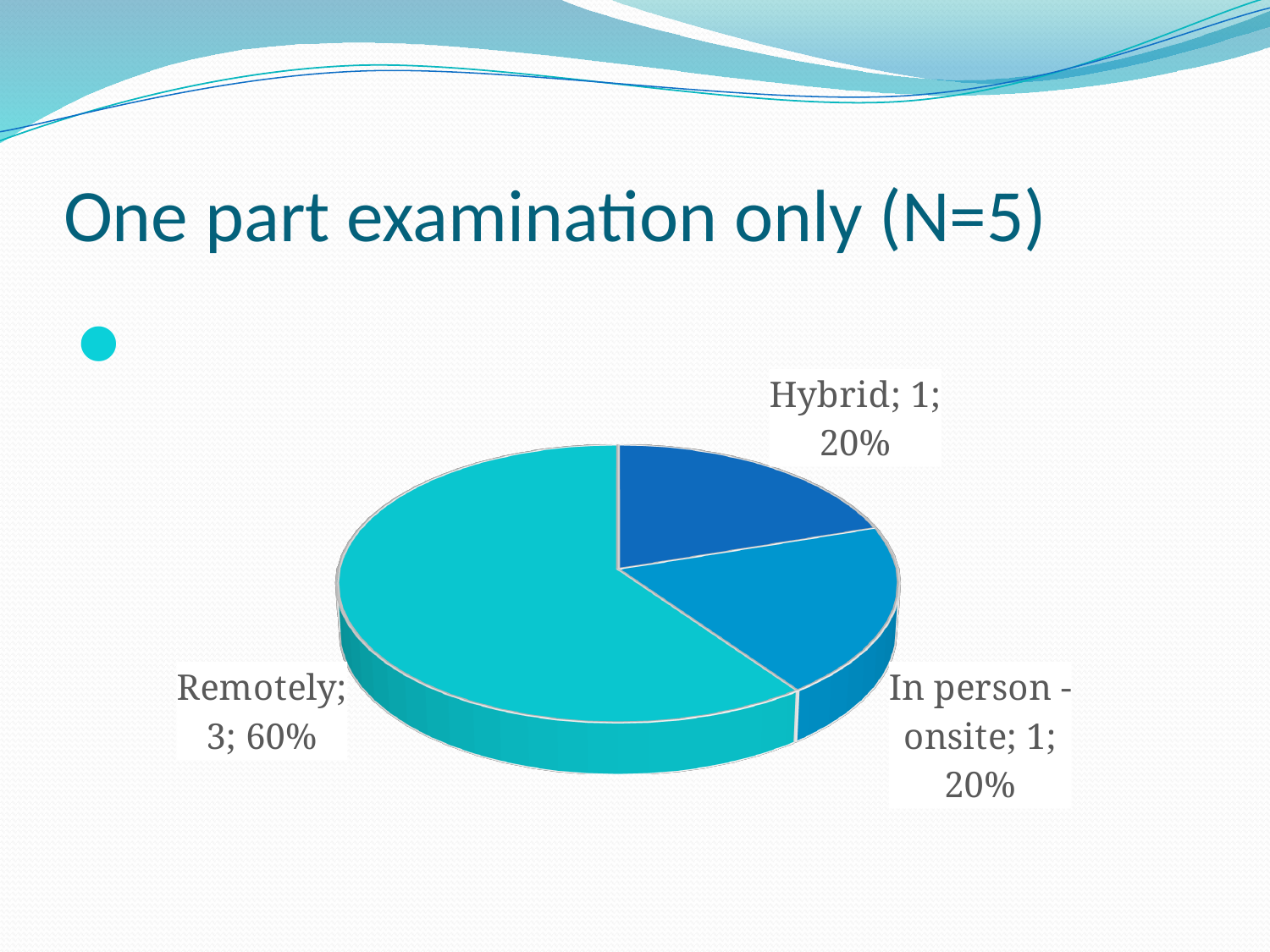
What is the count for In person - onsite? 1 How many slices does the pie chart have? 3 What is the difference between the count for Remotely and the count for Hybrid? 2 What share of the pie does Hybrid represent? 20% What kind of chart is shown on the slide? pie chart Which category has the largest slice? Remotely What is the total count across all slices of the pie? 5 What is the count for Remotely? 3 What is the count for Hybrid? 1 What share of the pie does Remotely represent? 60% What is the title of the slide containing the chart? One part examination only (N=5) Which is larger, the slice for Remotely or the slice for In person - onsite? Remotely